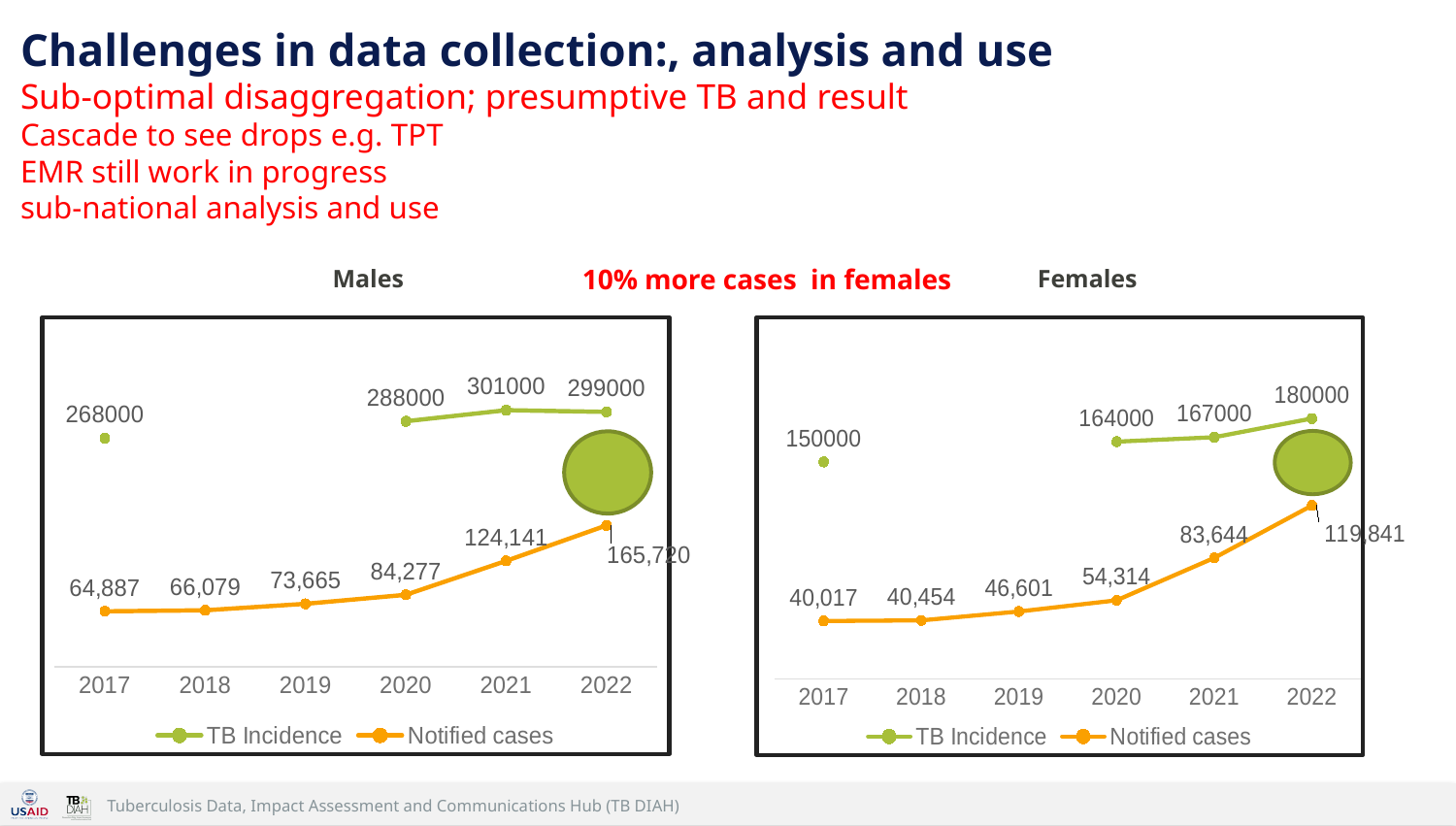
In the Males chart, which year has the highest TB Incidence value? 2021 In the Males chart, what is the TB Incidence value for 2021? 301000 In the Females chart, which year has the lowest Notified cases value? 2017 In the Females chart, what is the difference between TB Incidence in 2022 and 2021? 13000 In the Males chart, what is the difference between Notified cases in 2022 and 2021? 41,579 In the Females chart, what is the value of Notified cases in 2019? 46,601 How many series does the legend of the Females chart list? 2 In the Females chart, what is the TB Incidence value for 2022? 180000 In the Males chart, what is the value of Notified cases in 2022? 165,720 In the Males chart, which is larger: Notified cases in 2020 or Notified cases in 2019? 2020 In the Females chart, do Notified cases rise or fall from 2017 to 2022? Rise What type of chart is the Males chart? Line chart